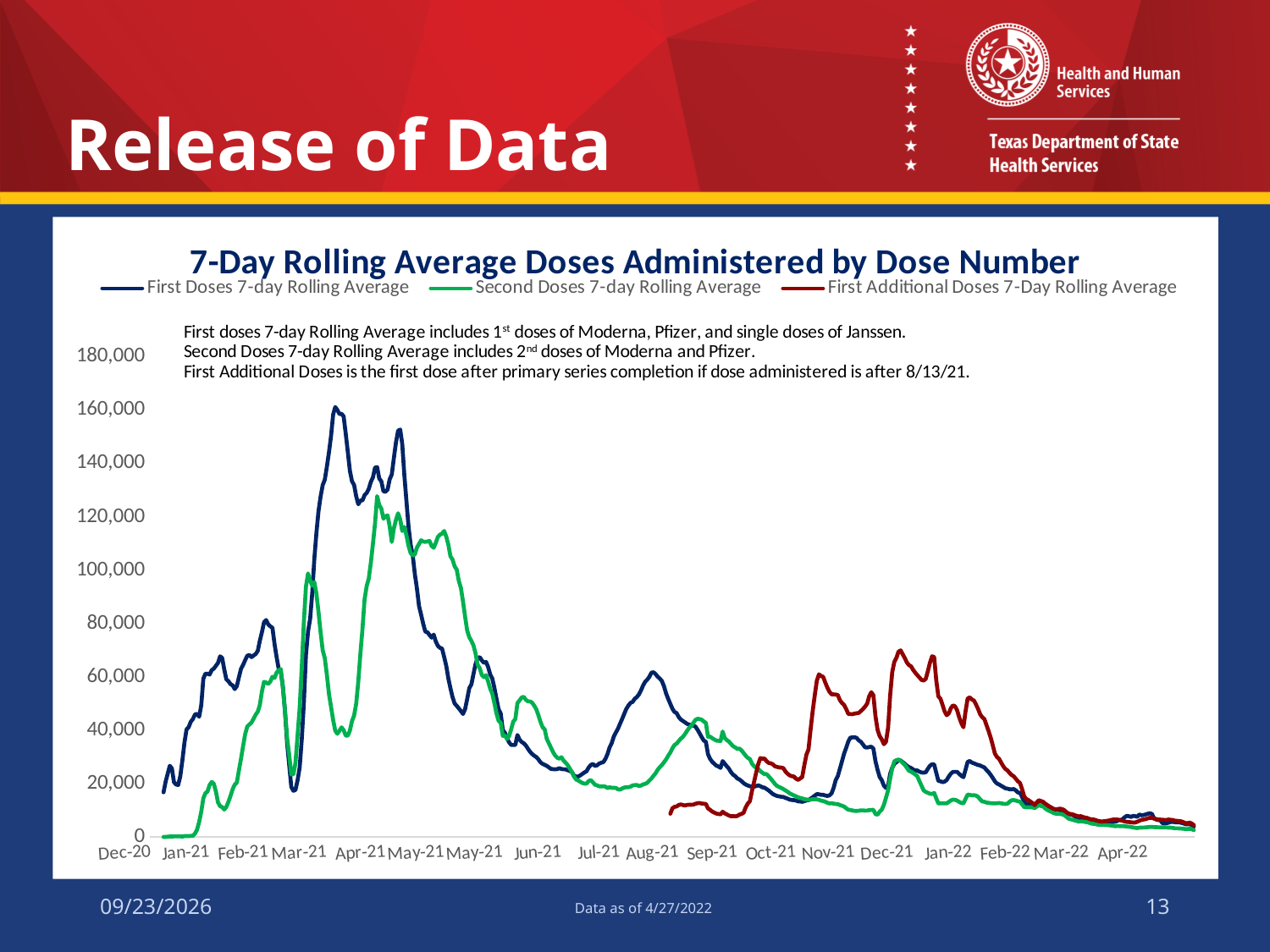
Is the peak value of the Second Doses 7-day Rolling Average greater or less than 140,000? less Which colour is used for the Second Doses 7-day Rolling Average line? green What kind of chart is shown on the slide? line chart Which series begins latest along the x axis? First Additional Doses 7-Day Rolling Average Is the peak value of the First Doses 7-day Rolling Average greater or less than 140,000? greater Do the values of the First Doses 7-day Rolling Average rise or fall between Apr-21 and Jul-21? fall Around Nov-21, which is higher: the First Additional Doses 7-Day Rolling Average or the First Doses 7-day Rolling Average? First Additional Doses 7-Day Rolling Average What is the highest value labelled on the y axis? 180,000 What is the title of the chart? 7-Day Rolling Average Doses Administered by Dose Number How many series does the chart's legend list? 3 Is the peak value of the First Additional Doses 7-Day Rolling Average greater or less than 80,000? less Which series reaches the highest peak on the chart? First Doses 7-day Rolling Average